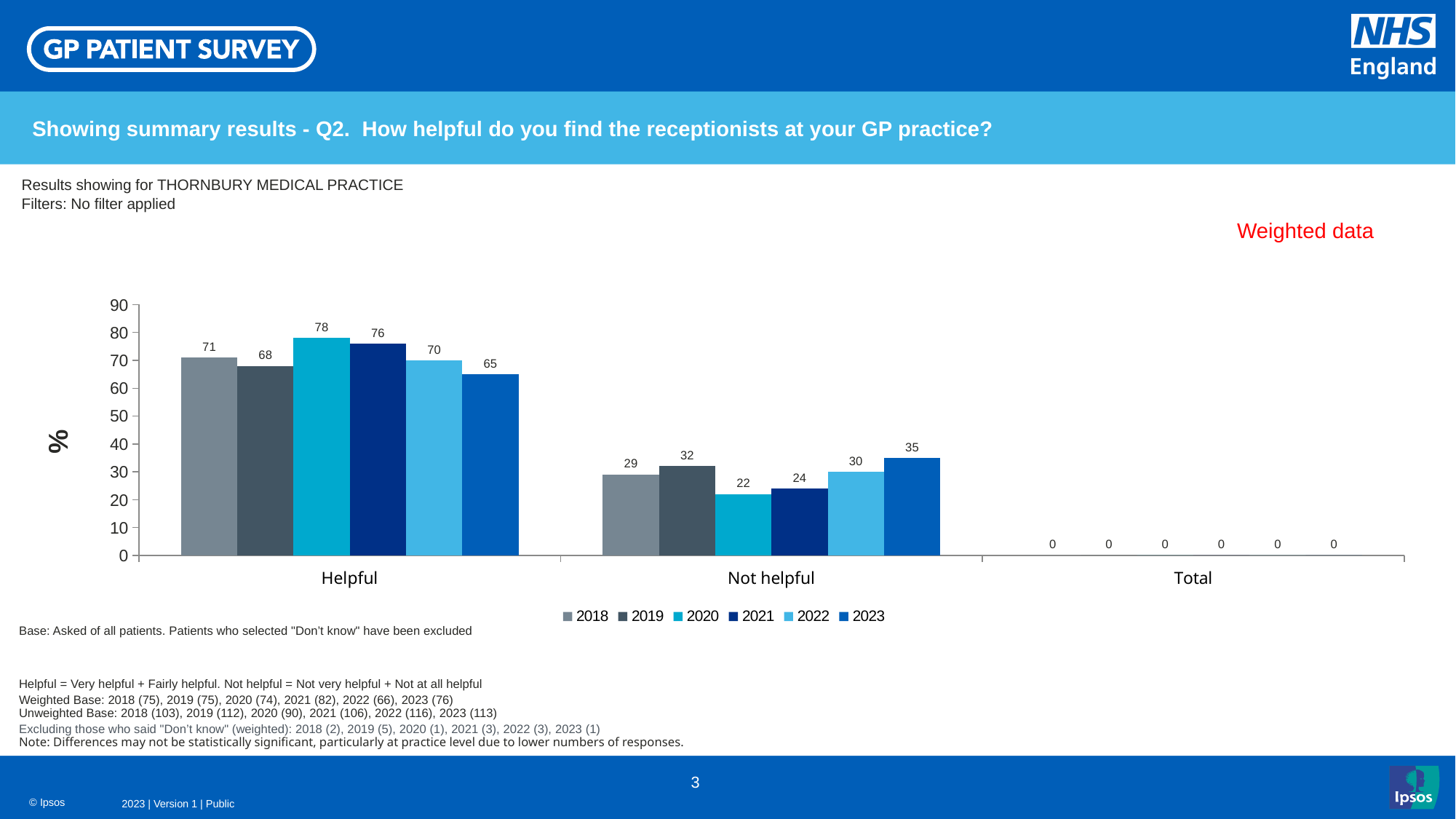
How many categories are shown on the x axis? 3 Which is larger: the 2019 value for Not helpful or the 2022 value for Not helpful? 2019 What is the value for 2018 in the Helpful category? 71 Which year has the highest value in the Helpful category? 2020 What is the value for 2020 in the Helpful category? 78 What label is shown on the y axis? % What is the value for every year in the Total category? 0 How many series does the legend list? 6 Which year has the lowest value in the Not helpful category? 2020 What is the value for 2023 in the Not helpful category? 35 What kind of chart is shown on the slide? Bar chart What is the difference between the 2020 and 2023 values in the Helpful category? 13